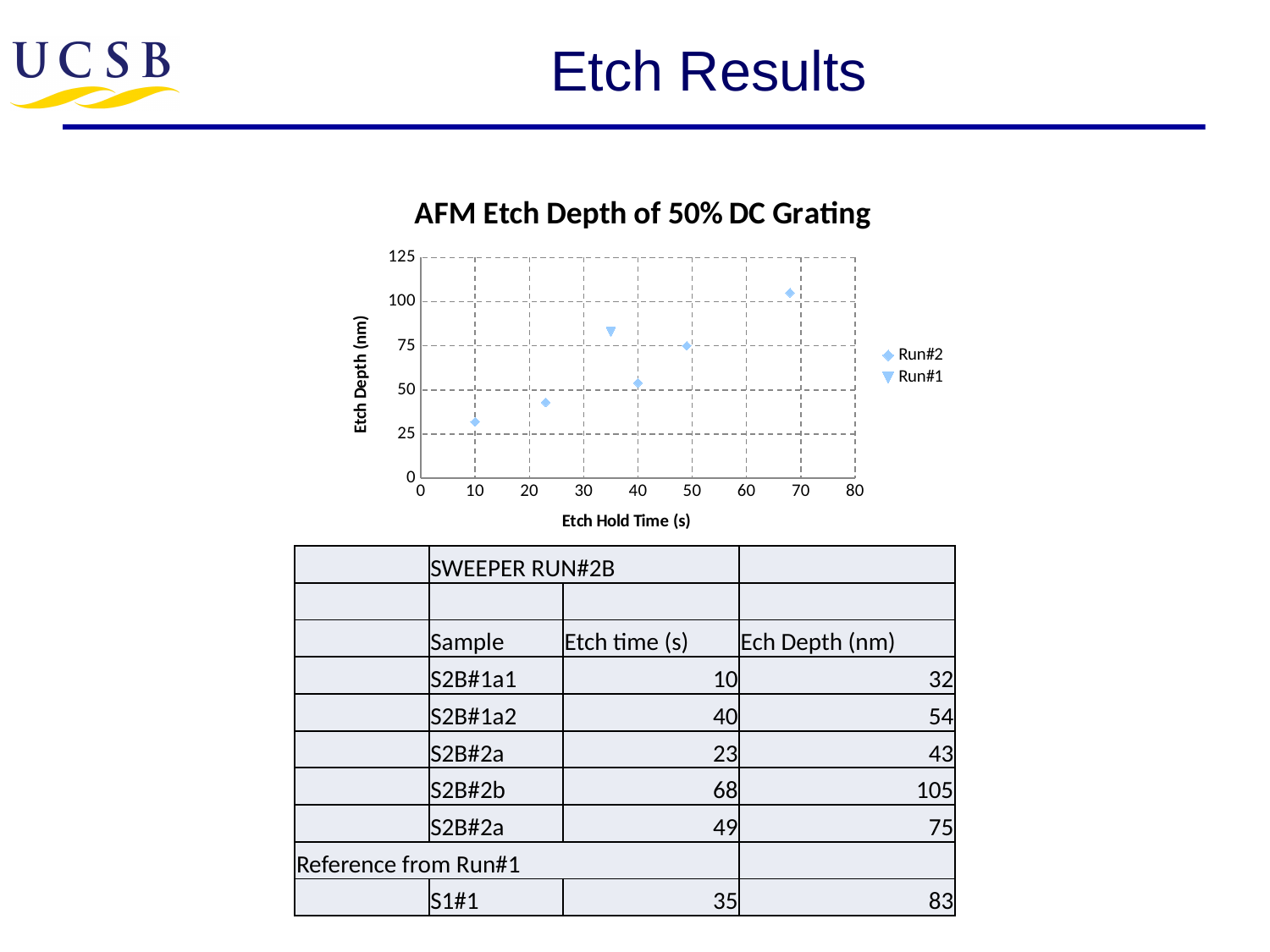
How many data points are plotted for Run#1? 1 Is the Run#2 etch depth at 10 s hold time greater or less than 50? less Do the Run#2 etch depth values rise or fall as etch hold time increases? rise How many data points are plotted for Run#2? 5 What is the title of the chart? AFM Etch Depth of 50% DC Grating What kind of chart is shown on the slide? scatter chart How many series does the legend of the chart list? 2 Which has the larger etch depth: the Run#1 point at 35 s or the Run#2 point at 40 s? Run#1 at 35 s Is the Run#2 etch depth at 68 s hold time greater or less than 100? greater At which etch hold time does Run#2 have the lowest etch depth? 10 s At which etch hold time does Run#2 have the highest etch depth? 68 s What is the Run#2 etch depth at an etch hold time of 49 s? 75